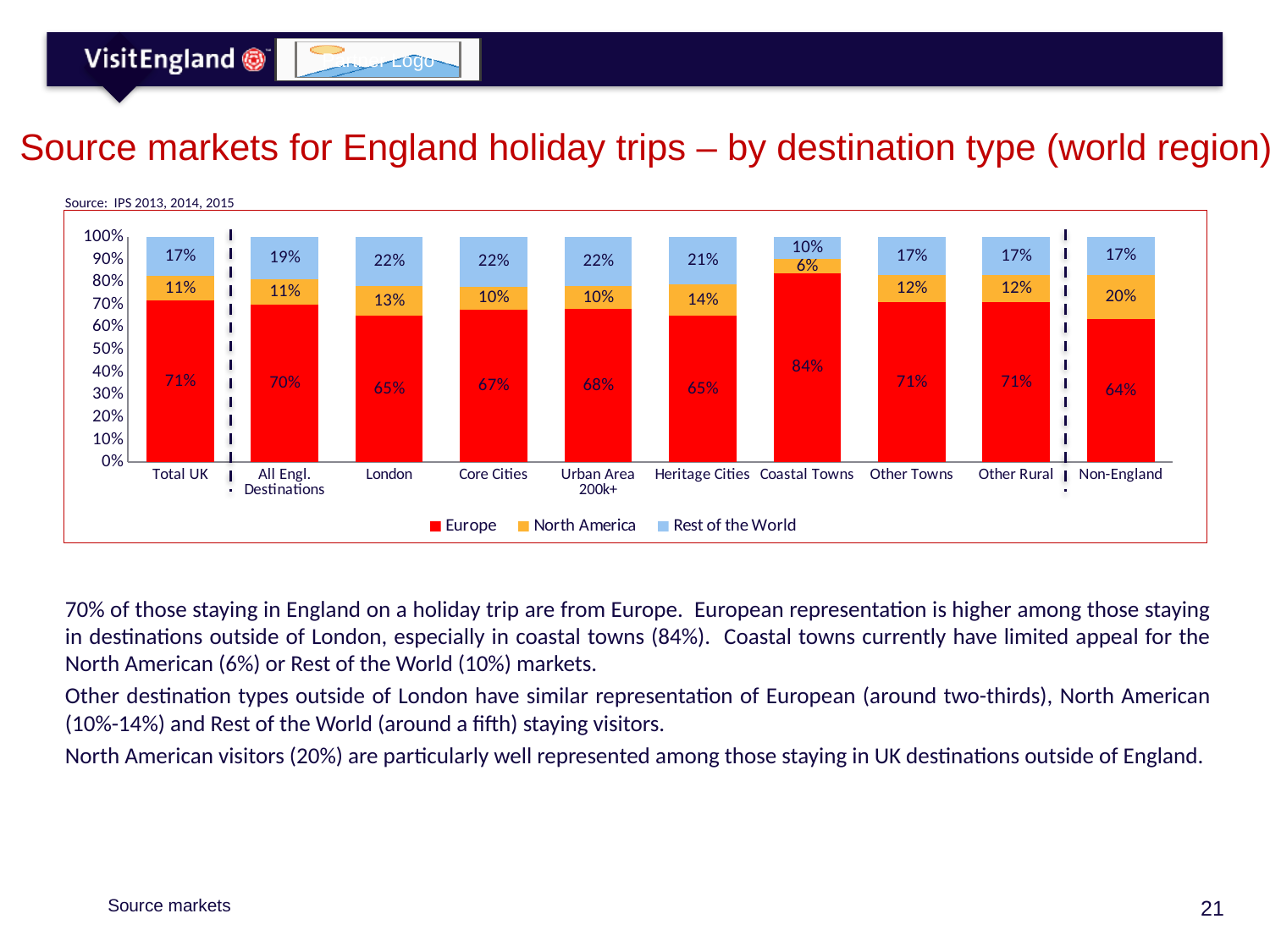
Which has a larger Rest of the World share, Heritage Cities or Other Towns? Heritage Cities How many series does the legend list? 3 How many destination categories are shown on the x axis? 10 What is the difference between the North America share for Heritage Cities and for Core Cities? 4% Which series is shown in red in the chart? Europe What is the North America share for Non-England destinations? 20% What kind of chart is shown on the slide? Stacked bar chart What percentage of holiday trips to Coastal Towns come from Europe? 84% What is the Rest of the World share for London? 22% Which destination type has the highest Europe share? Coastal Towns Which destination type has the lowest North America share? Coastal Towns What is the difference between the Europe share for Coastal Towns and for Non-England? 20%